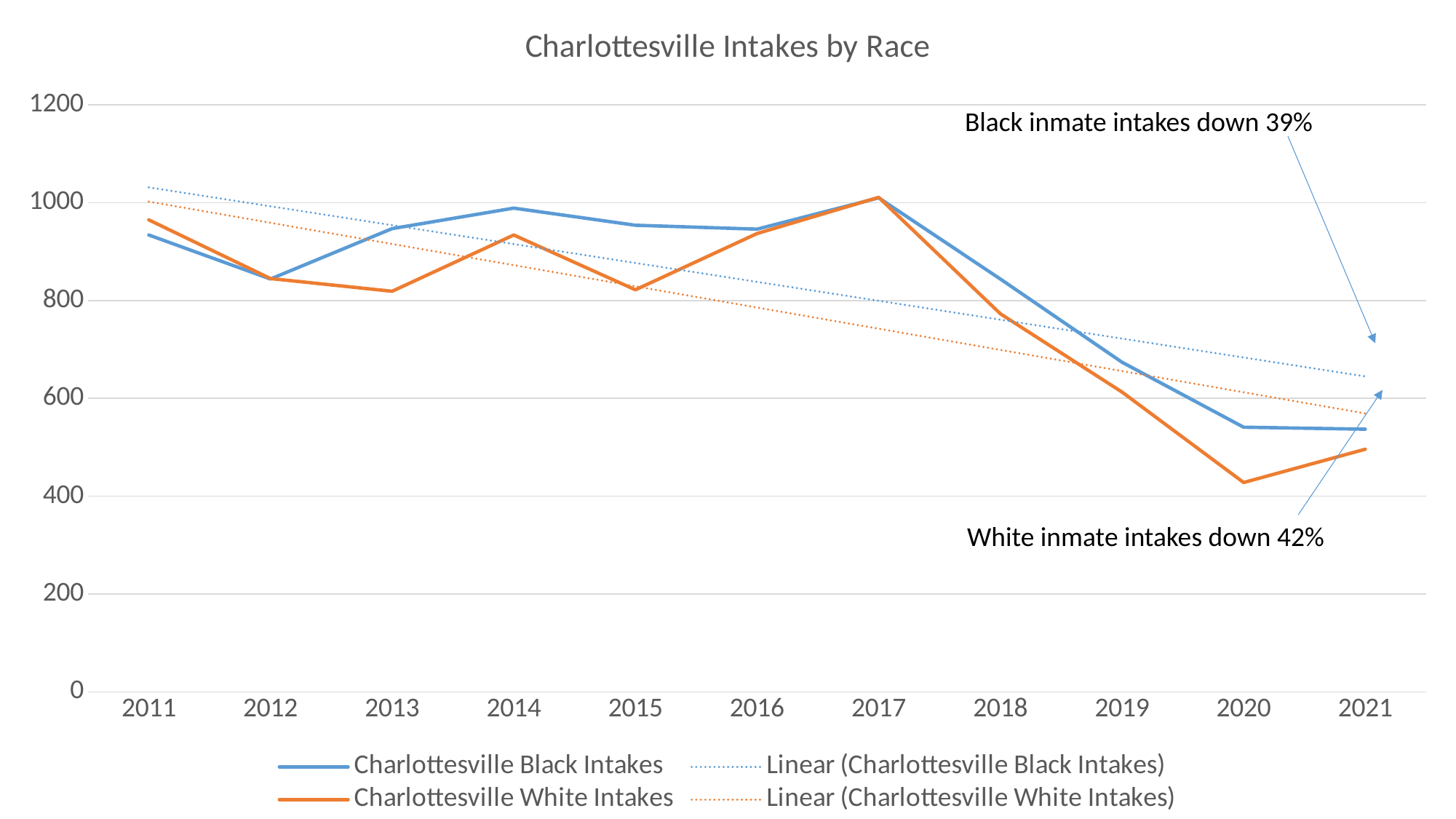
In 2013, which is larger: Charlottesville Black Intakes or Charlottesville White Intakes? Charlottesville Black Intakes According to the annotation on the chart, by what percentage are White inmate intakes down? 42% How many years are shown on the x axis? 11 What is the title of the chart? Charlottesville Intakes by Race Is the value for Charlottesville White Intakes in 2020 greater or less than 600? less Is the value for Charlottesville Black Intakes in 2020 greater or less than 600? less How many series does the legend list? 4 Is the value for Charlottesville Black Intakes in 2014 greater or less than 800? greater What kind of chart is shown on the slide? line chart Do Charlottesville Black Intakes generally rise or fall from 2017 to 2021? fall In which year are Charlottesville White Intakes highest? 2017 In which year are Charlottesville White Intakes lowest? 2020